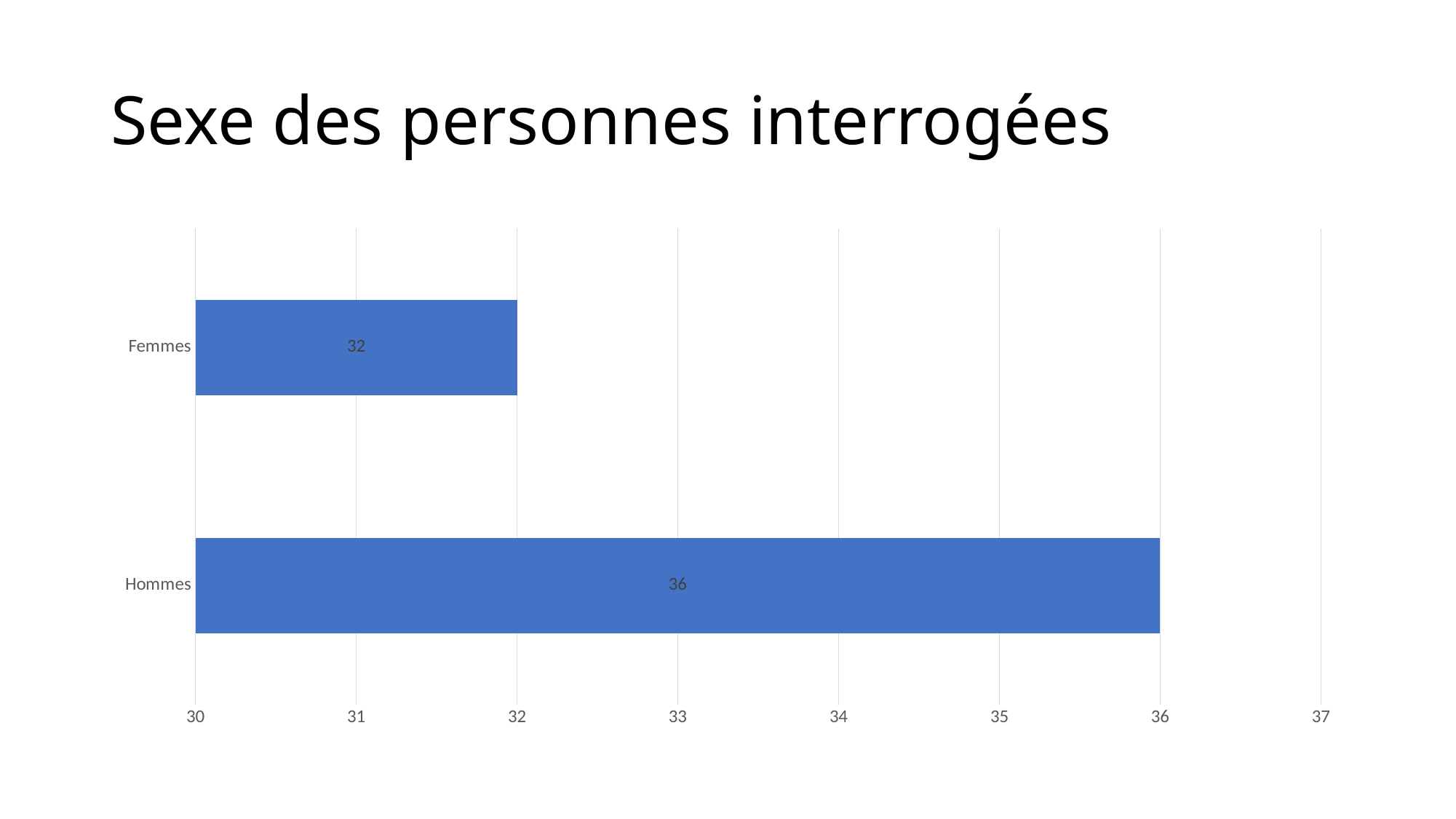
Is the value for Femmes greater or less than 33? less What is the highest value shown on the horizontal axis? 37 Which is larger, the value for Femmes or the value for Hommes? Hommes Is the value for Hommes greater or less than 34? greater What is the difference between the values for Hommes and Femmes? 4 What is the value for Hommes? 36 What is the value for Femmes? 32 What is the title of the slide? Sexe des personnes interrogées How many categories are shown in the chart? 2 Which category has the lowest value? Femmes What kind of chart is shown on the slide? bar chart Which category has the highest value? Hommes